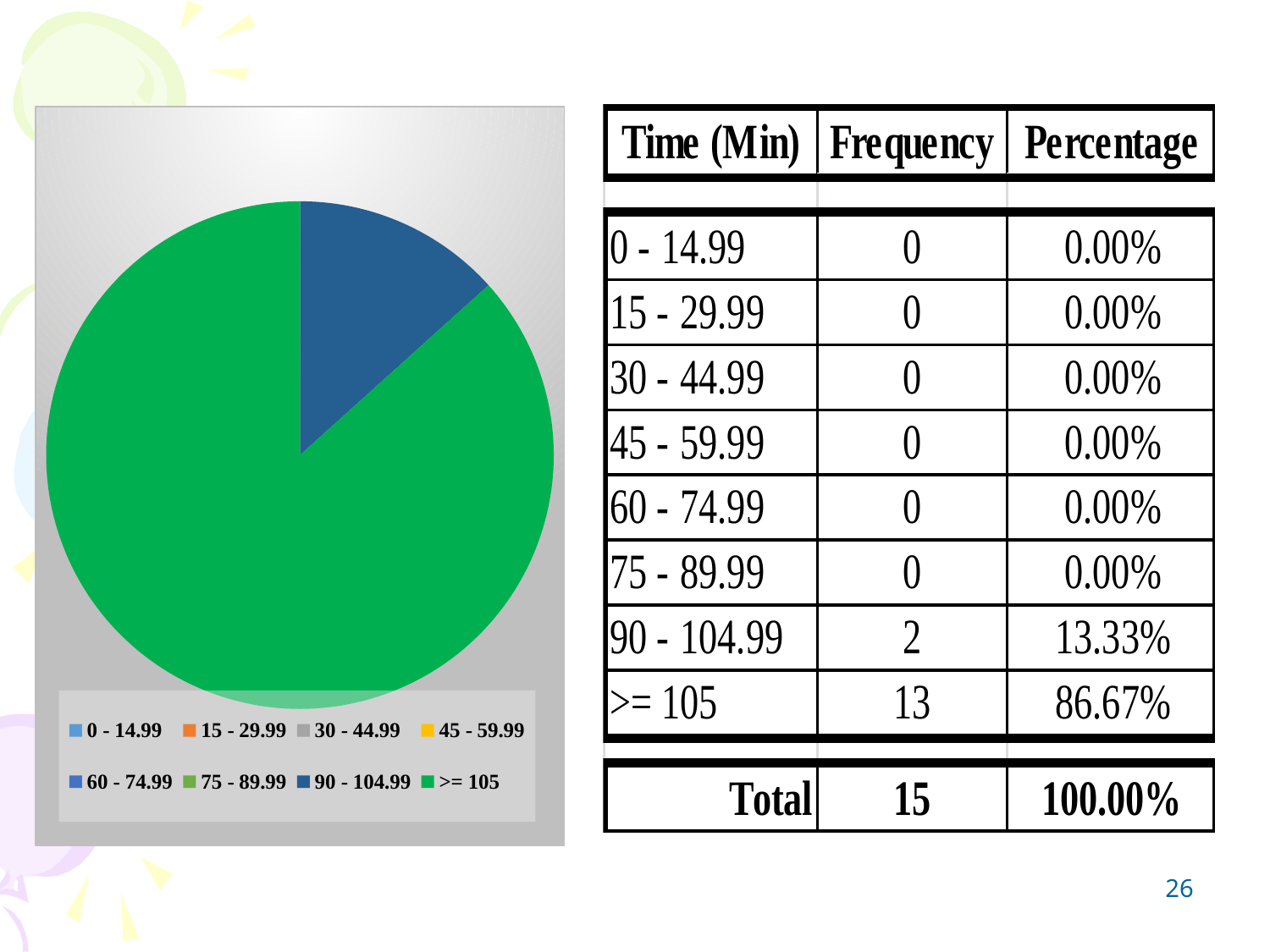
Which is larger, the slice for >= 105 or the slice for 90 - 104.99? >= 105 What percentage does the >= 105 category account for? 86.67% What is the frequency for the 90 - 104.99 category? 2 What kind of chart is shown on the slide? pie chart Which category has the largest slice of the pie chart? >= 105 How many categories does the pie chart's legend list? 8 What is the total frequency across all categories? 15 What is the difference in frequency between the >= 105 and 90 - 104.99 categories? 11 What colour is the slice for the >= 105 category? green What is the frequency for the >= 105 category? 13 What is the frequency for the 0 - 14.99 category? 0 What percentage does the 90 - 104.99 category account for? 13.33%